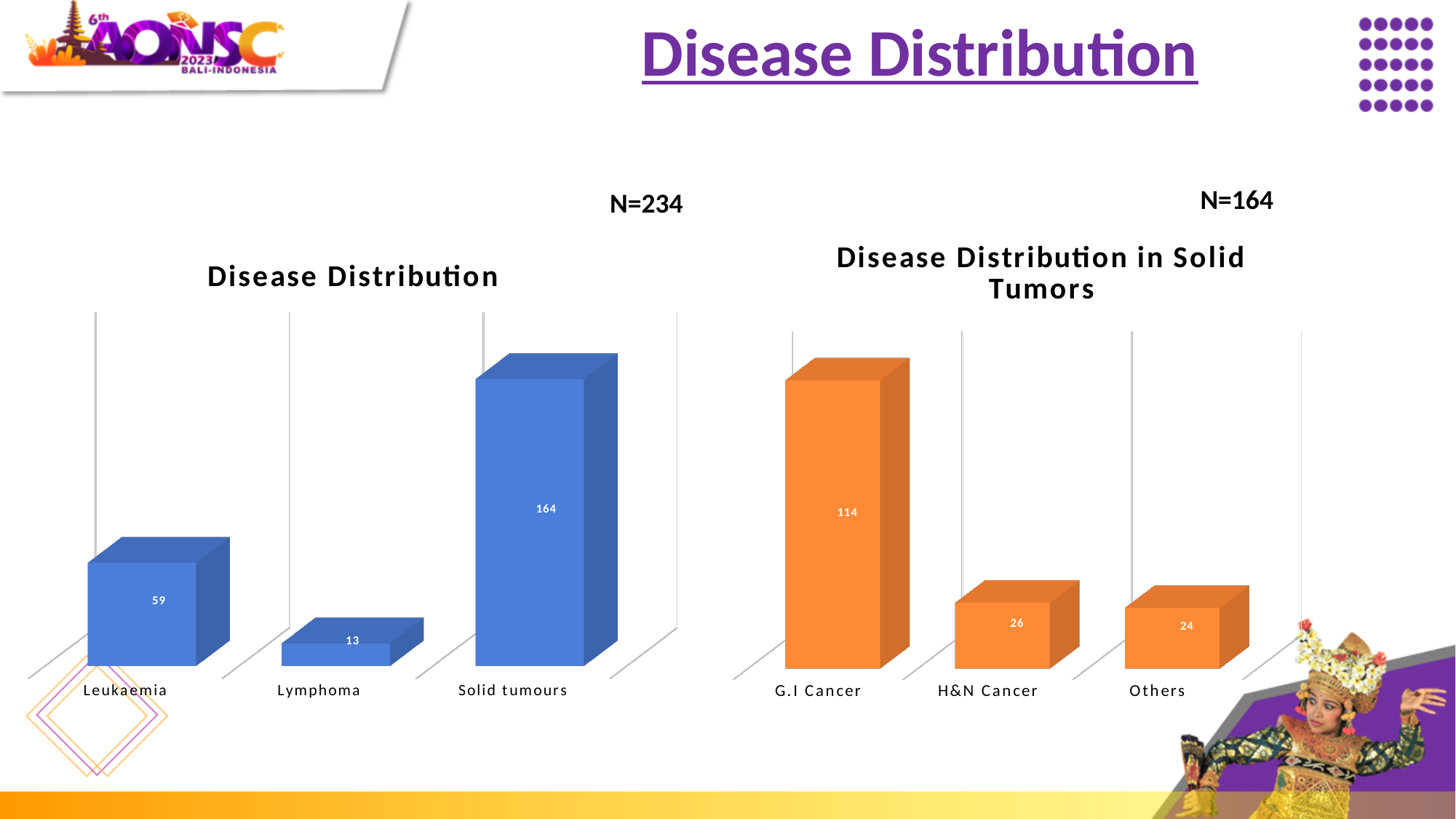
In the 'Disease Distribution' chart, which category has the highest value? Solid tumours In the 'Disease Distribution in Solid Tumors' chart, what is the value for Others? 24 What kind of chart is the 'Disease Distribution in Solid Tumors' chart? Bar chart In the 'Disease Distribution' chart, how many categories are shown? 3 In the 'Disease Distribution' chart, what is the value for Leukaemia? 59 In the 'Disease Distribution in Solid Tumors' chart, what is the difference between G.I Cancer and H&N Cancer? 88 In the 'Disease Distribution in Solid Tumors' chart, which is larger, H&N Cancer or Others? H&N Cancer What colour are the bars in the 'Disease Distribution in Solid Tumors' chart? Orange In the 'Disease Distribution' chart, what is the value for Lymphoma? 13 In the 'Disease Distribution' chart, what is the difference between Solid tumours and Leukaemia? 105 In the 'Disease Distribution in Solid Tumors' chart, what is the value for G.I Cancer? 114 In the 'Disease Distribution' chart, which category has the lowest value? Lymphoma